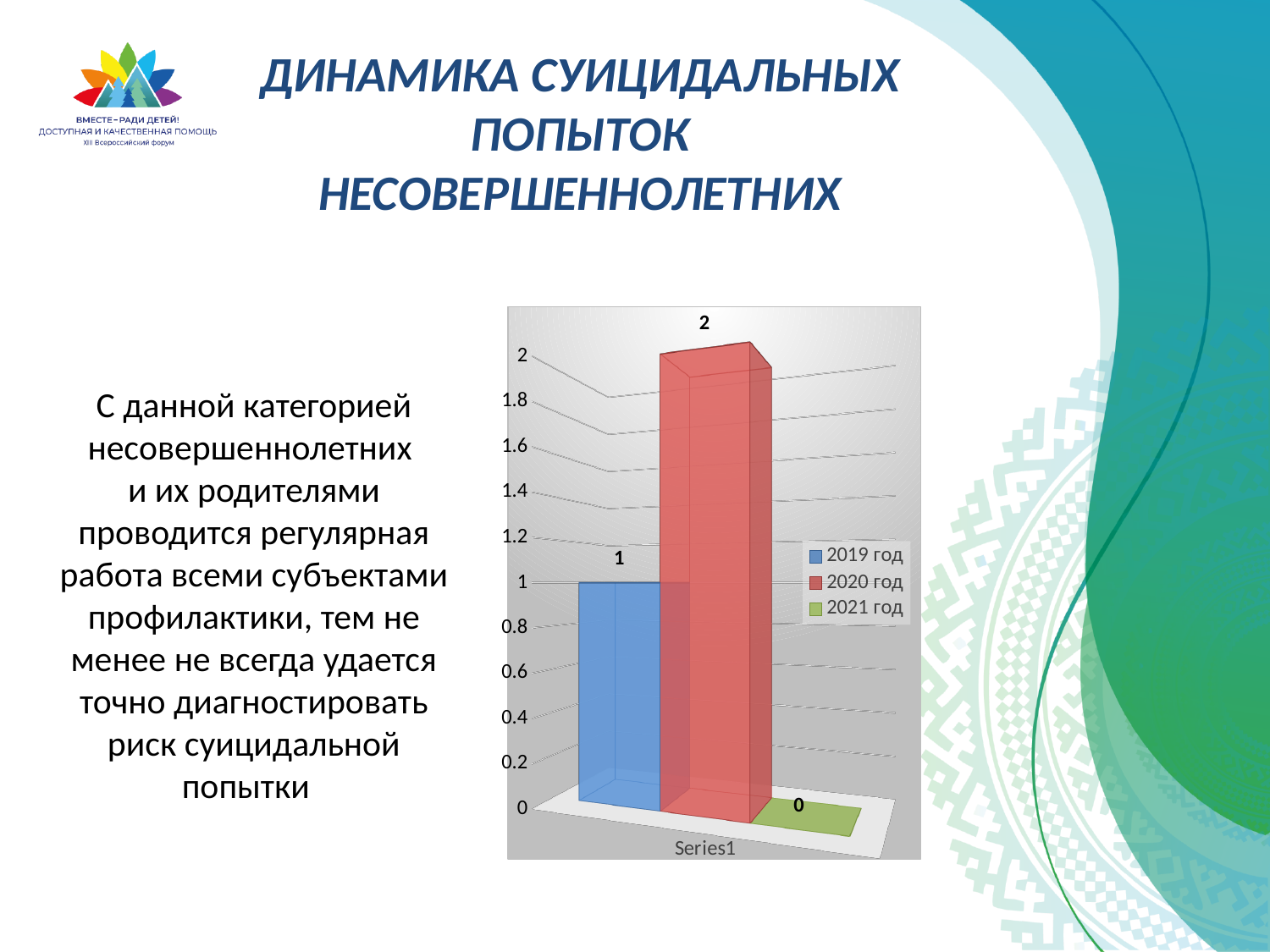
What is the difference between the values for 2020 год and 2019 год? 1 Which series has the highest value? 2020 год Which is larger, the value for 2019 год or the value for 2021 год? 2019 год Which series has the lowest value? 2021 год What kind of chart is shown on the slide? bar chart What is the value for 2019 год? 1 What colour is the bar for 2020 год? red What is the total of the values for 2019 год, 2020 год and 2021 год? 3 What is the value for 2020 год? 2 What is the category label shown on the x axis? Series1 How many series does the legend list? 3 What is the value for 2021 год? 0